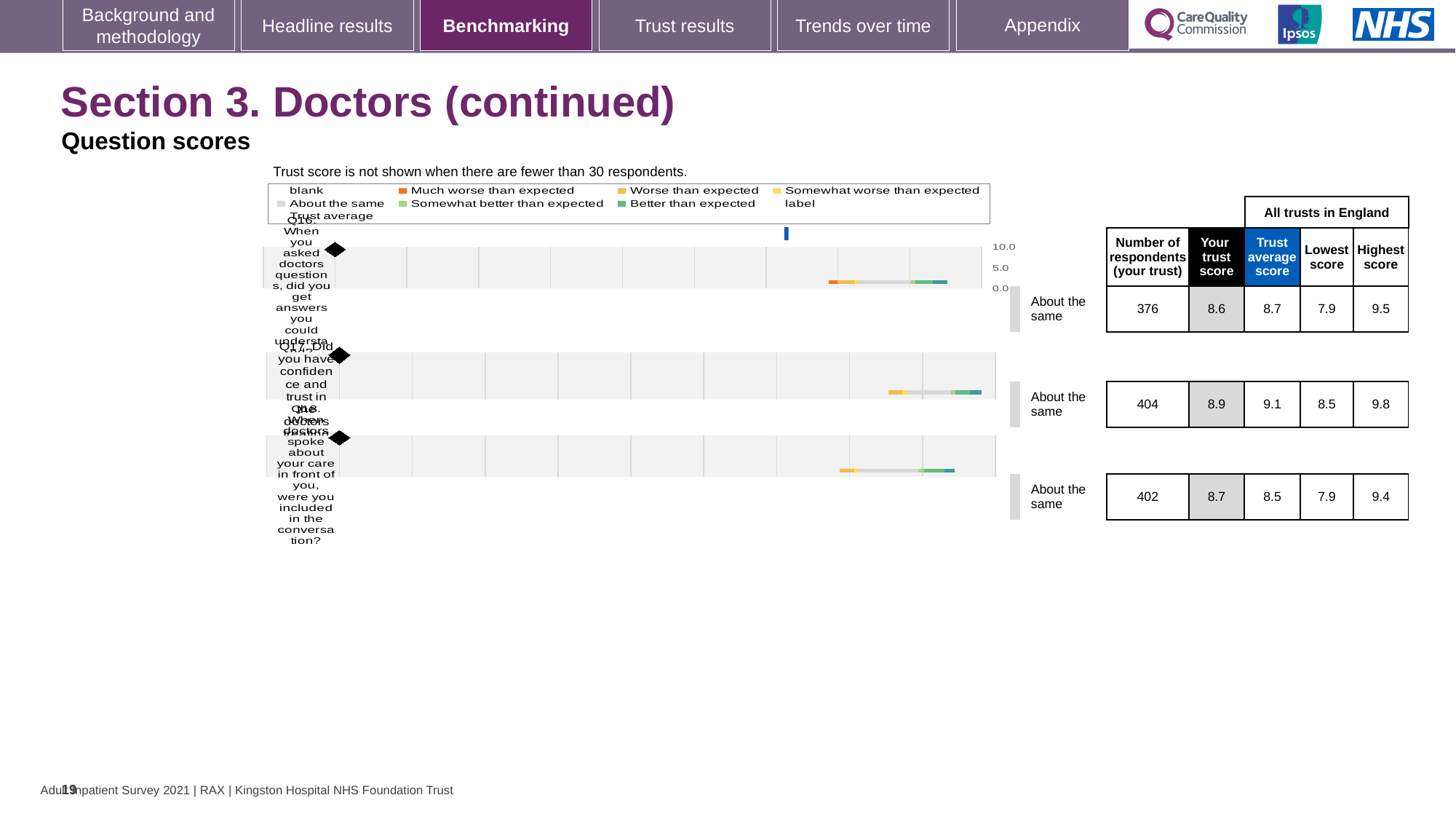
Which question has the lowest number of respondents from your trust? Q16 How many respondents from your trust answered Q16? 376 What is the highest score across all trusts in England for Q18? 9.4 What is the trust average score for Q18? 8.5 Which question has the highest 'Your trust score'? Q17 How many questions are plotted in the chart? 3 What is the 'Your trust score' for Q17 (Did you have confidence and trust in the doctors)? 8.9 What kind of chart is used to show the question scores on this slide? bar chart What is the difference between the highest score and the lowest score for Q17? 1.3 What benchmark category is shown next to each of the three questions? About the same For Q16, which is larger: your trust score or the trust average score? Trust average score What is the maximum value shown on the chart's score axis? 10.0